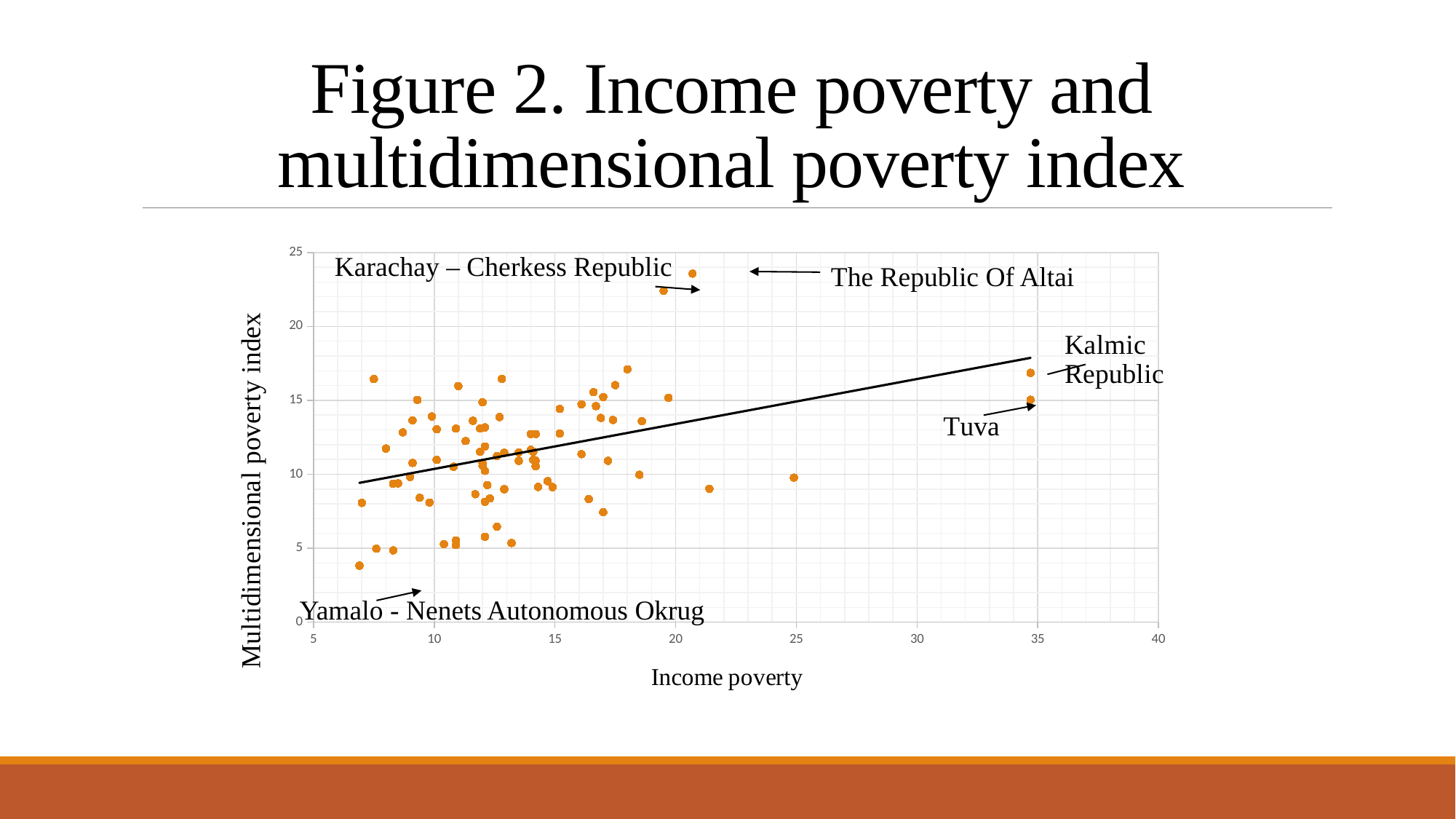
What kind of chart is shown on the slide? scatter plot What is the label of the x axis? Income poverty Is the income poverty value for Kalmic Republic greater or less than 30? greater Does the fitted trend line rise or fall as income poverty increases? rises How many regions are labelled by name on the chart? 5 Which has the higher multidimensional poverty index, Kalmic Republic or Tuva? Kalmic Republic Is the multidimensional poverty index for Tuva greater or less than 20? less What is the title of the chart on the slide? Figure 2. Income poverty and multidimensional poverty index Is the income poverty value for Karachay – Cherkess Republic greater or less than 15? greater Which of the labelled regions has the lowest multidimensional poverty index? Yamalo - Nenets Autonomous Okrug